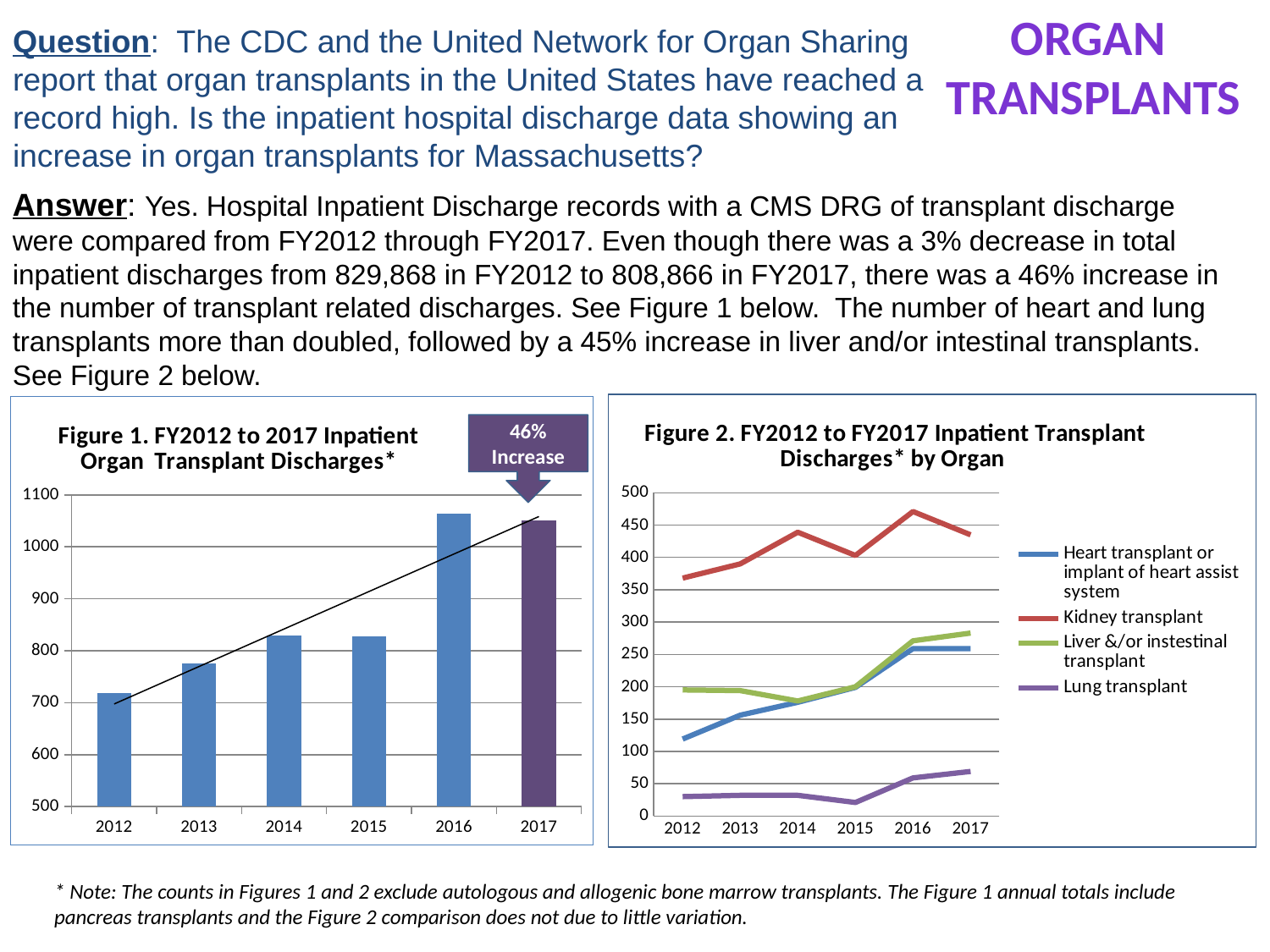
In Figure 1, which year has the lowest number of inpatient organ transplant discharges? 2012 In Figure 2, which organ series has the highest values across all years? Kidney transplant In Figure 1, how many years are shown on the x axis? 6 What kind of chart is Figure 1 (the left chart)? bar chart What kind of chart is Figure 2 (the right chart)? line chart In Figure 1, is the value for 2016 greater or less than 1000? greater In Figure 1, what percentage increase is called out in the annotation above the 2017 bar? 46% Increase In Figure 1, is the value for 2012 greater or less than 700? greater In Figure 1, is the value for 2013 greater or less than 800? less In Figure 2, how many series does the legend list? 4 In Figure 2, which organ series has the lowest values across all years? Lung transplant